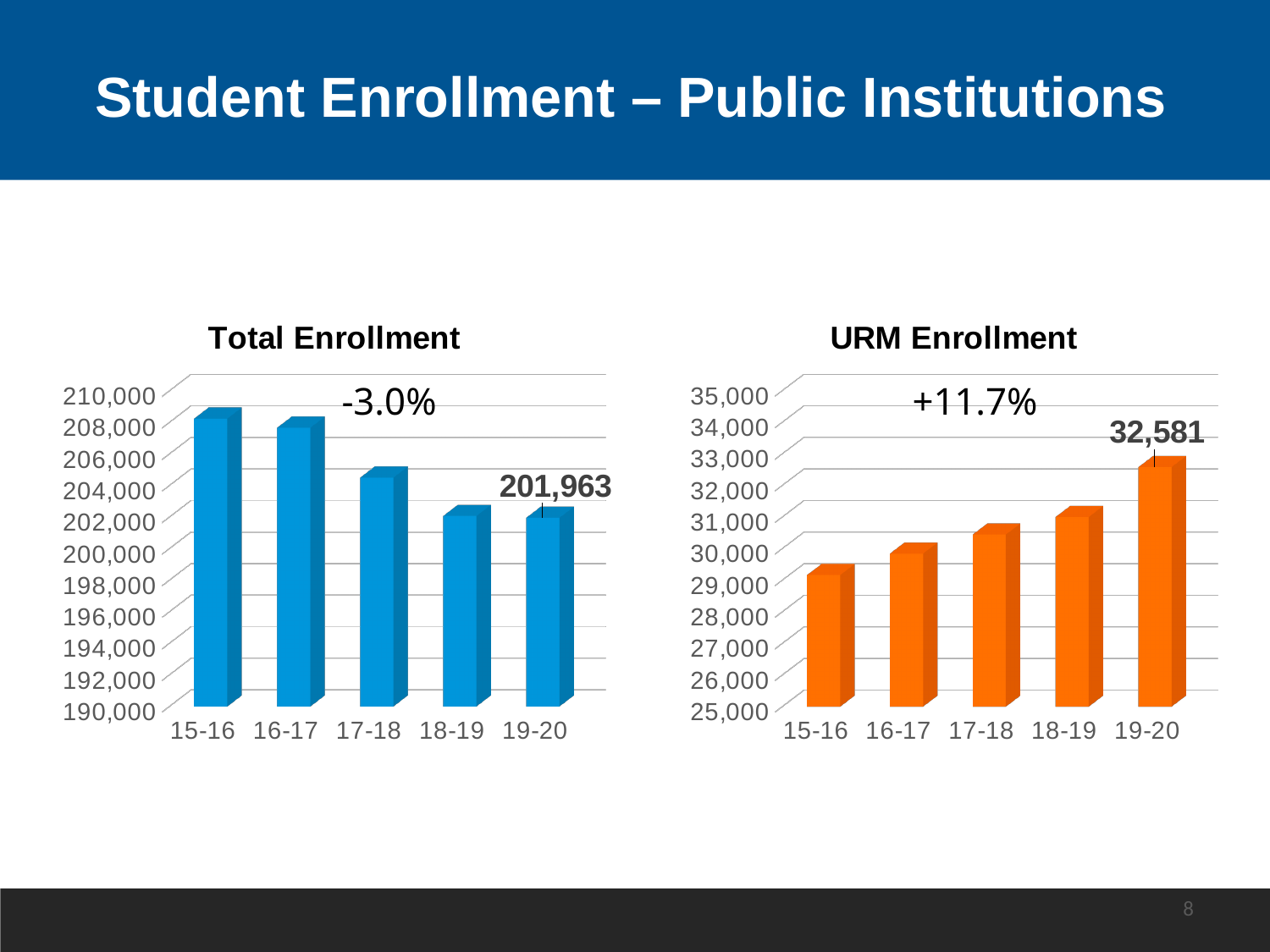
In the URM Enrollment chart, is the value for 16-17 greater or less than 31,000? less In the URM Enrollment chart, which year has the lowest enrollment? 15-16 In the URM Enrollment chart, do the values rise or fall from 15-16 to 19-20? Rise In the Total Enrollment chart, is the value for 15-16 greater or less than 206,000? greater In the Total Enrollment chart, what is the value for 19-20? 201,963 In the URM Enrollment chart, what is the value for 19-20? 32,581 How many years are shown in the URM Enrollment chart? 5 What kind of chart is the Total Enrollment chart? Bar chart In the Total Enrollment chart, which year has the highest enrollment? 15-16 In the URM Enrollment chart, which year has the highest enrollment? 19-20 What percentage change is annotated on the Total Enrollment chart? -3.0% In the Total Enrollment chart, is the value for 17-18 larger than the value for 18-19? Yes